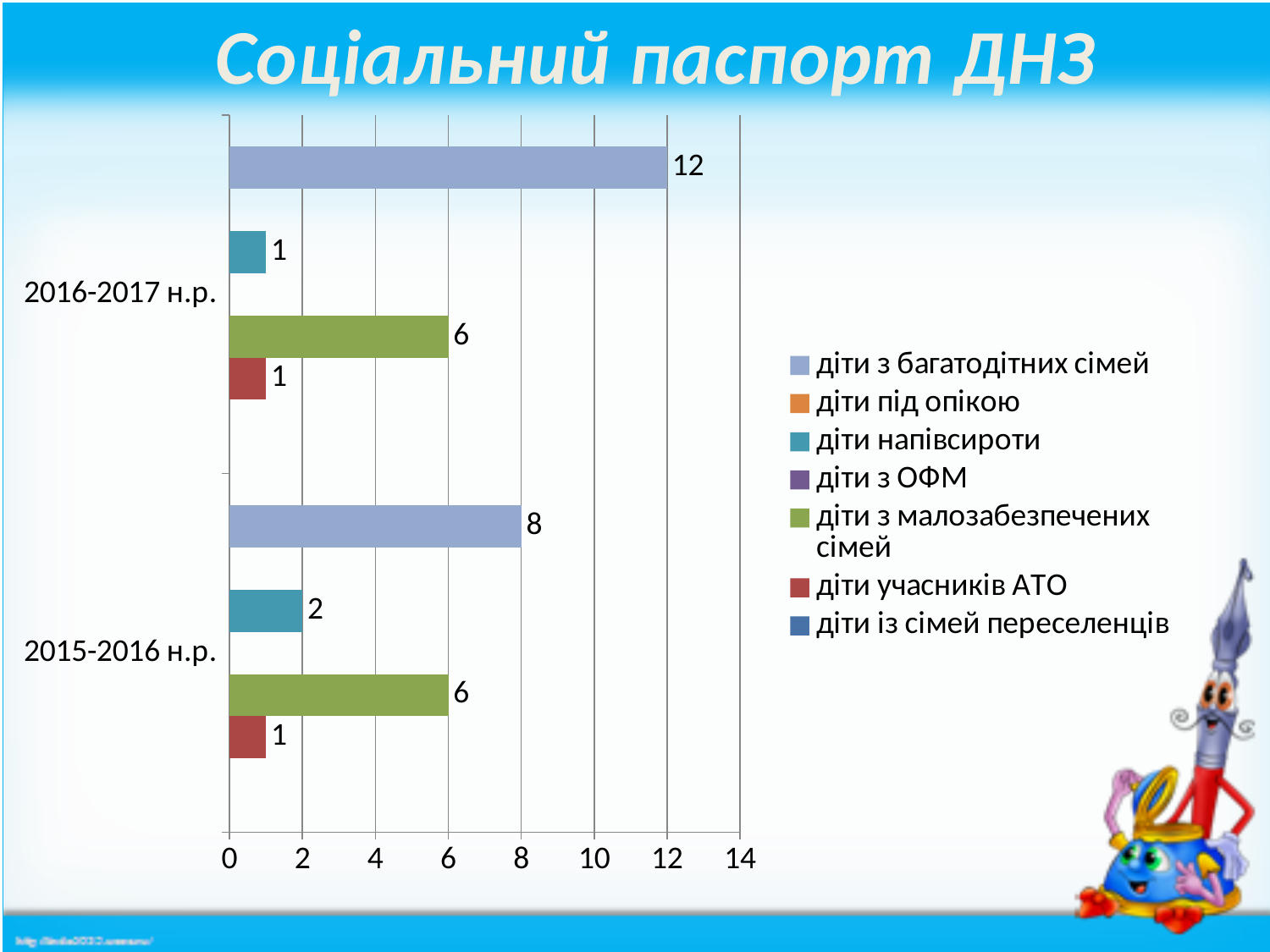
What is the title of the slide? Соціальний паспорт ДНЗ What is the value for діти з малозабезпечених сімей in 2016-2017 н.р.? 6 What is the value for діти з багатодітних сімей in 2016-2017 н.р.? 12 What is the value for діти напівсироти in 2015-2016 н.р.? 2 How many series does the legend list? 7 Which series has the highest value in 2016-2017 н.р.? діти з багатодітних сімей Which is larger: діти напівсироти in 2016-2017 н.р. or in 2015-2016 н.р.? 2015-2016 н.р. What is the value for діти учасників АТО in 2015-2016 н.р.? 1 What kind of chart is shown on the slide? bar chart How many school-year categories are shown on the vertical axis? 2 What is the difference between the values for діти з багатодітних сімей in 2016-2017 н.р. and 2015-2016 н.р.? 4 What is the value for діти з багатодітних сімей in 2015-2016 н.р.? 8